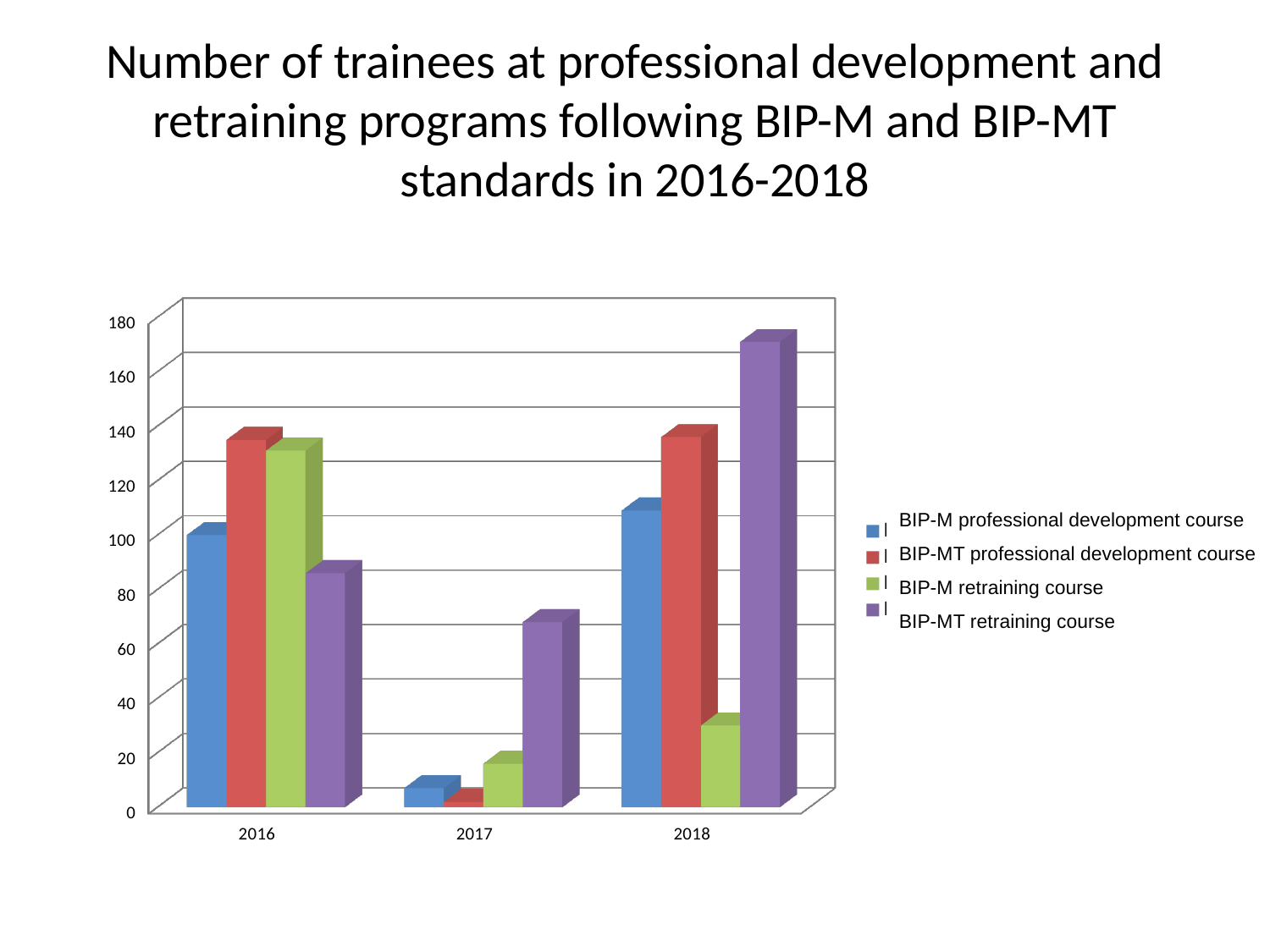
Is the value for the BIP-M retraining course in 2018 greater or less than 60? less Is the value for the BIP-M professional development course in 2016 greater or less than 80? greater How many series does the legend list? 4 How many years are shown on the x axis? 3 Which year has the lowest value for the BIP-M professional development course? 2017 Does the value for the BIP-M professional development course rise or fall from 2016 to 2017? fall What kind of chart is shown on the slide? bar chart Which series has the lowest value in 2017? BIP-MT professional development course Is the value for the BIP-MT retraining course in 2017 greater or less than 100? less Which series has the highest value in 2018? BIP-MT retraining course In 2018, which is larger: the BIP-MT retraining course or the BIP-MT professional development course? BIP-MT retraining course Which year has the highest value for the BIP-MT retraining course? 2018